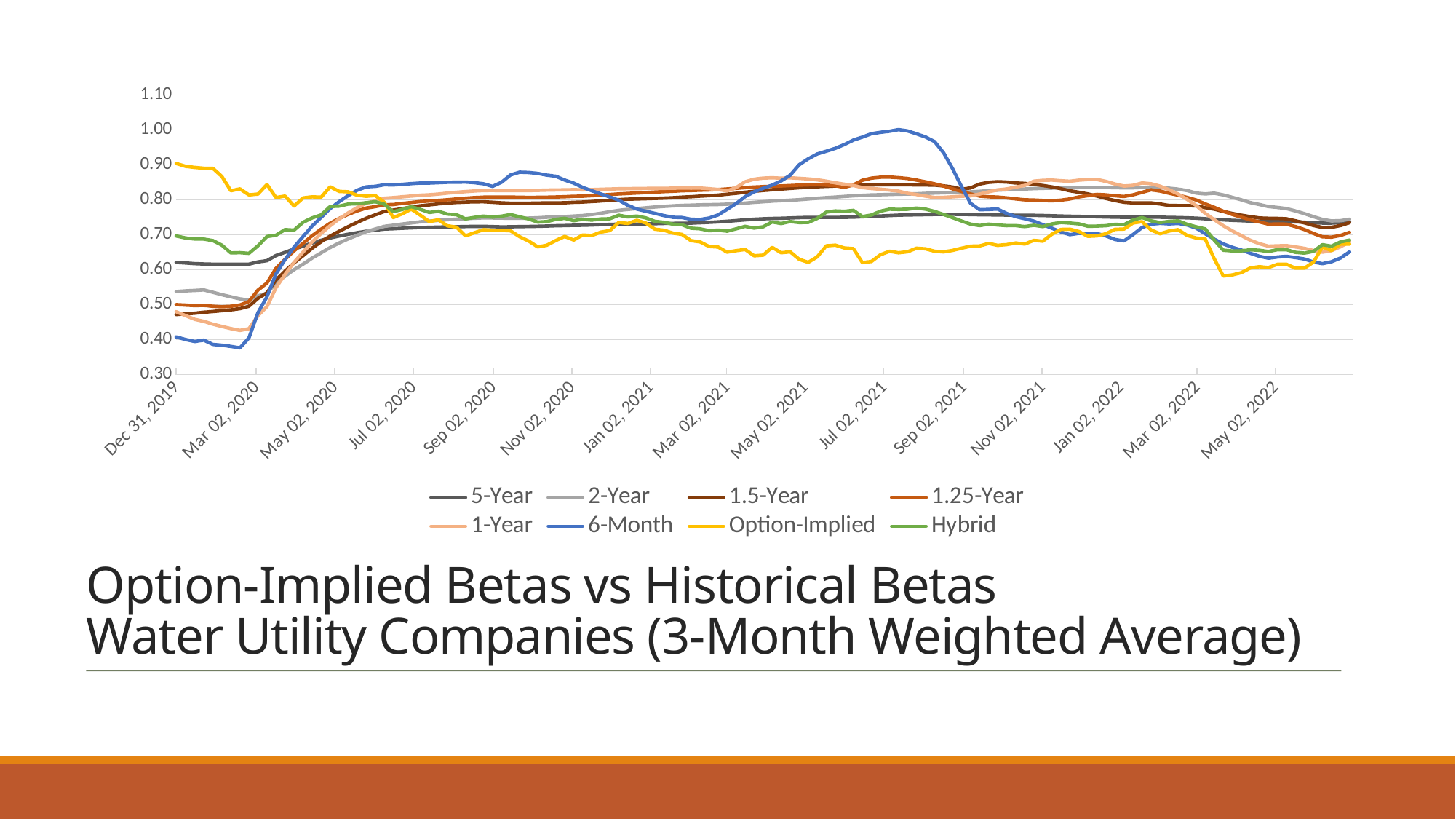
Which series has the lowest value around Jul 02, 2021? Option-Implied Does the 6-Month series rise or fall between Mar 02, 2020 and Jul 02, 2020? rise Which series reaches the highest peak around Jul 02, 2021? 6-Month What kind of chart is shown on the slide? line chart Is the Option-Implied value at Dec 31, 2019 greater or less than 0.80? greater How many series does the legend list? 8 Does the Option-Implied series rise or fall between Dec 31, 2019 and Mar 02, 2020? fall Which series has the highest value at Dec 31, 2019? Option-Implied Is the 6-Month value at Dec 31, 2019 greater or less than 0.50? less What colour is the Option-Implied line in the chart? yellow Is the peak of the 6-Month series around Jul 02, 2021 greater or less than 0.90? greater Which series has the lowest value at Dec 31, 2019? 6-Month